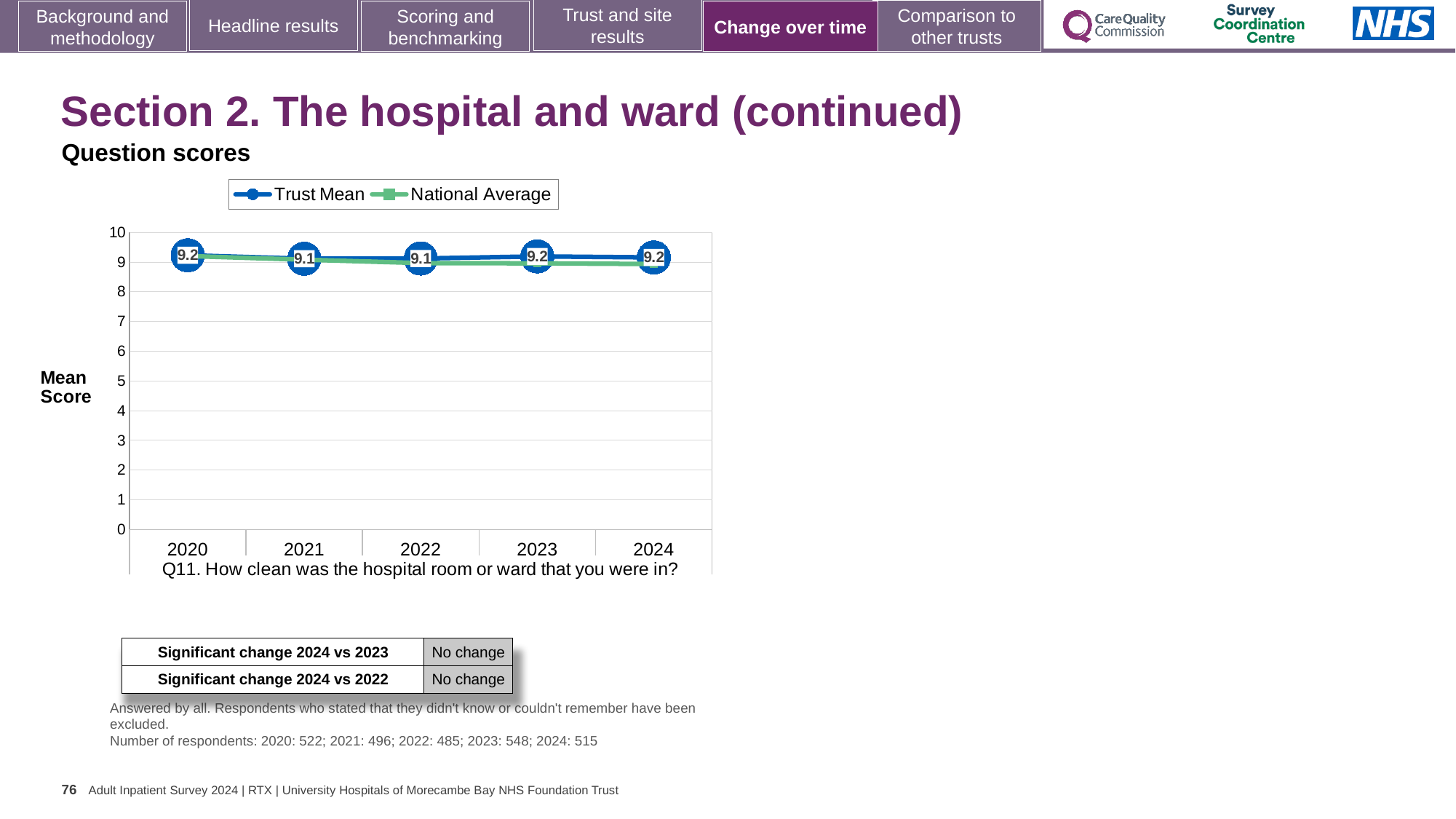
What kind of chart is shown? line chart How many series does the legend list? 2 What is the difference between the Trust Mean score for 2023 and for 2022? 0.1 What is the Trust Mean score for 2024? 9.2 Is the National Average for 2024 greater or less than 8? greater How many years are shown on the x axis? 5 What is the Trust Mean score for 2020? 9.2 Is the Trust Mean score for 2023 greater or less than 8? greater What is the Trust Mean score for 2021? 9.1 What is the Trust Mean score for 2022? 9.1 What question is the chart about, as shown below the x axis? Q11. How clean was the hospital room or ward that you were in? Which is larger, the Trust Mean score for 2020 or for 2021? 2020